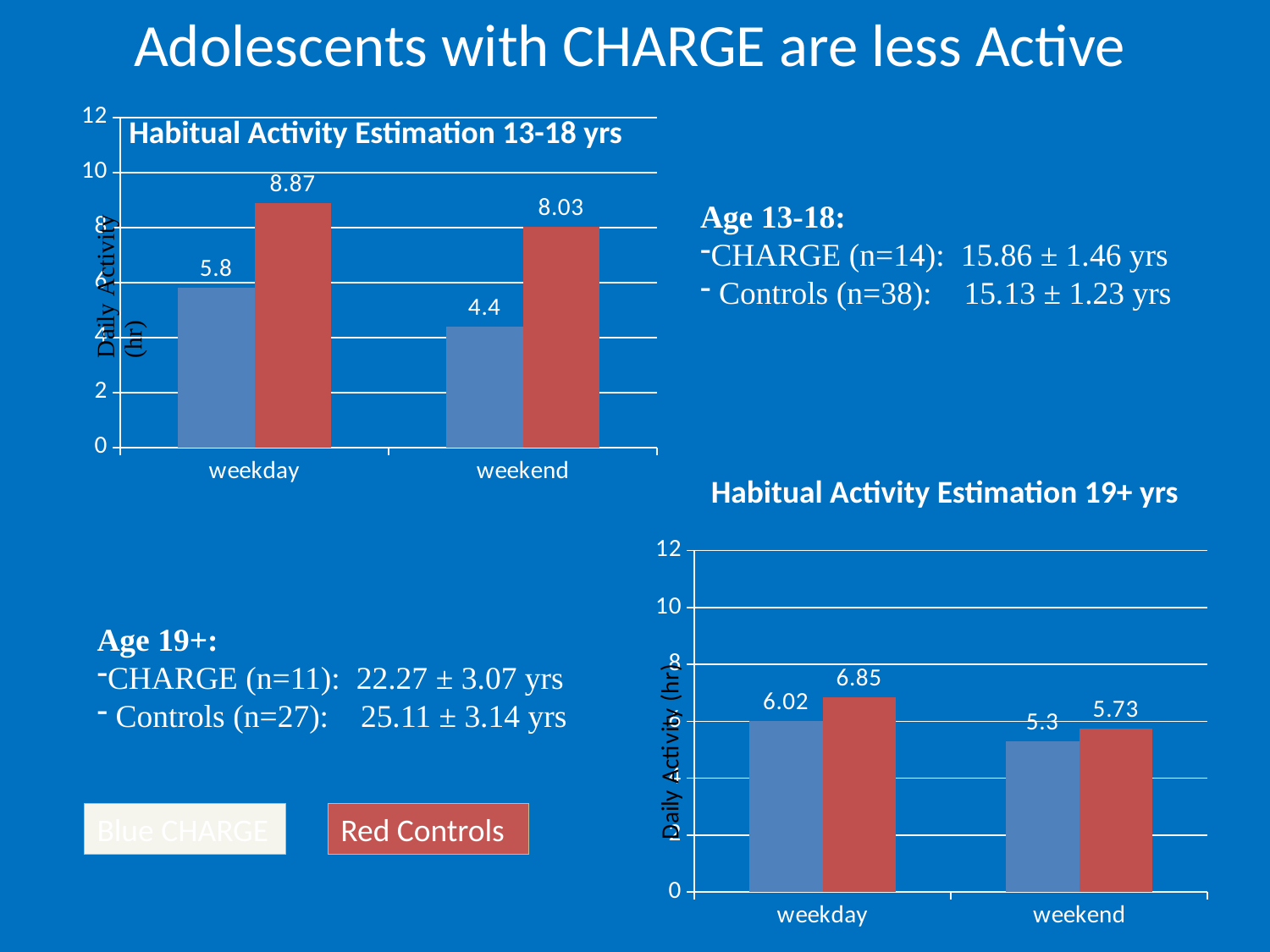
In the 'Habitual Activity Estimation 19+ yrs' chart, what is the difference between the Controls and CHARGE weekend values? 0.43 In the 'Habitual Activity Estimation 13-18 yrs' chart, which bar has the lowest value? CHARGE weekend (4.4) How many categories are shown on the x axis of the 'Habitual Activity Estimation 19+ yrs' chart? 2 In the 'Habitual Activity Estimation 13-18 yrs' chart, what is the difference between the Controls and CHARGE weekday values? 3.07 In the 'Habitual Activity Estimation 19+ yrs' chart, what is the weekday value for the Controls (red) bar? 6.85 In the 'Habitual Activity Estimation 13-18 yrs' chart, is the Controls weekday value greater or less than 8? greater In the 'Habitual Activity Estimation 19+ yrs' chart, what is the weekend value for the CHARGE (blue) bar? 5.3 What type of chart is the 'Habitual Activity Estimation 13-18 yrs' chart? Bar chart In the 'Habitual Activity Estimation 19+ yrs' chart, which is larger: the CHARGE weekday value or the CHARGE weekend value? CHARGE weekday (6.02) In the 'Habitual Activity Estimation 13-18 yrs' chart, what is the weekend value for the Controls (red) bar? 8.03 In the 'Habitual Activity Estimation 13-18 yrs' chart, which bar has the highest value? Controls weekday (8.87) In the 'Habitual Activity Estimation 13-18 yrs' chart, what is the weekday value for the CHARGE (blue) bar? 5.8